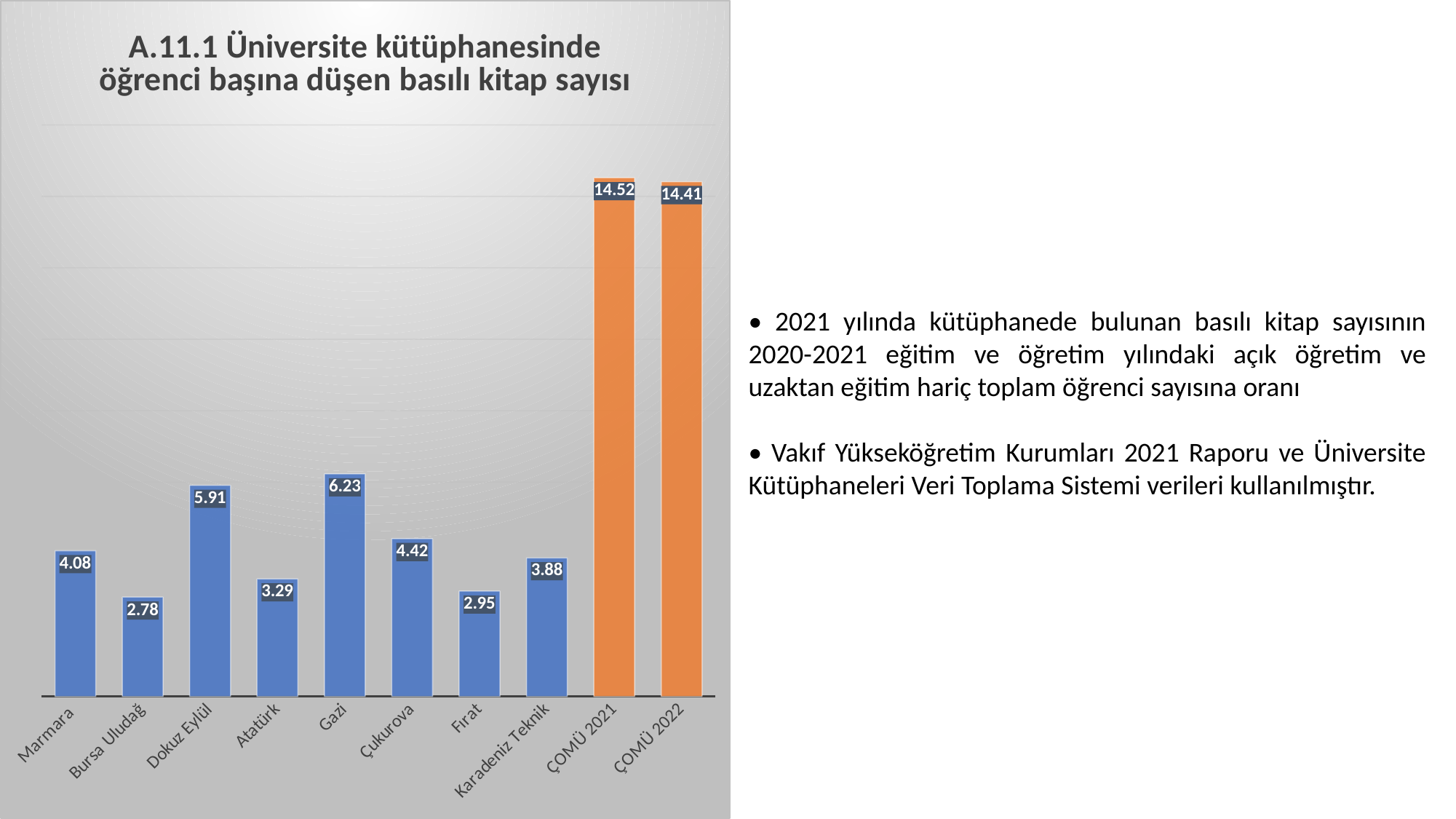
Which category has the lowest value? Bursa Uludağ What is the value for Karadeniz Teknik? 3.88 What is the difference between the values for ÇOMÜ 2021 and ÇOMÜ 2022? 0.11 What kind of chart is shown on the slide? Bar chart How many categories are shown on the x axis? 10 Which bars are coloured orange rather than blue? ÇOMÜ 2021 and ÇOMÜ 2022 Which category has the highest value? ÇOMÜ 2021 Which is larger, the value for Çukurova or the value for Atatürk? Çukurova What is the value for Gazi? 6.23 What is the value for ÇOMÜ 2022? 14.41 What is the value for Marmara? 4.08 What is the difference between the values for Gazi and Dokuz Eylül? 0.32